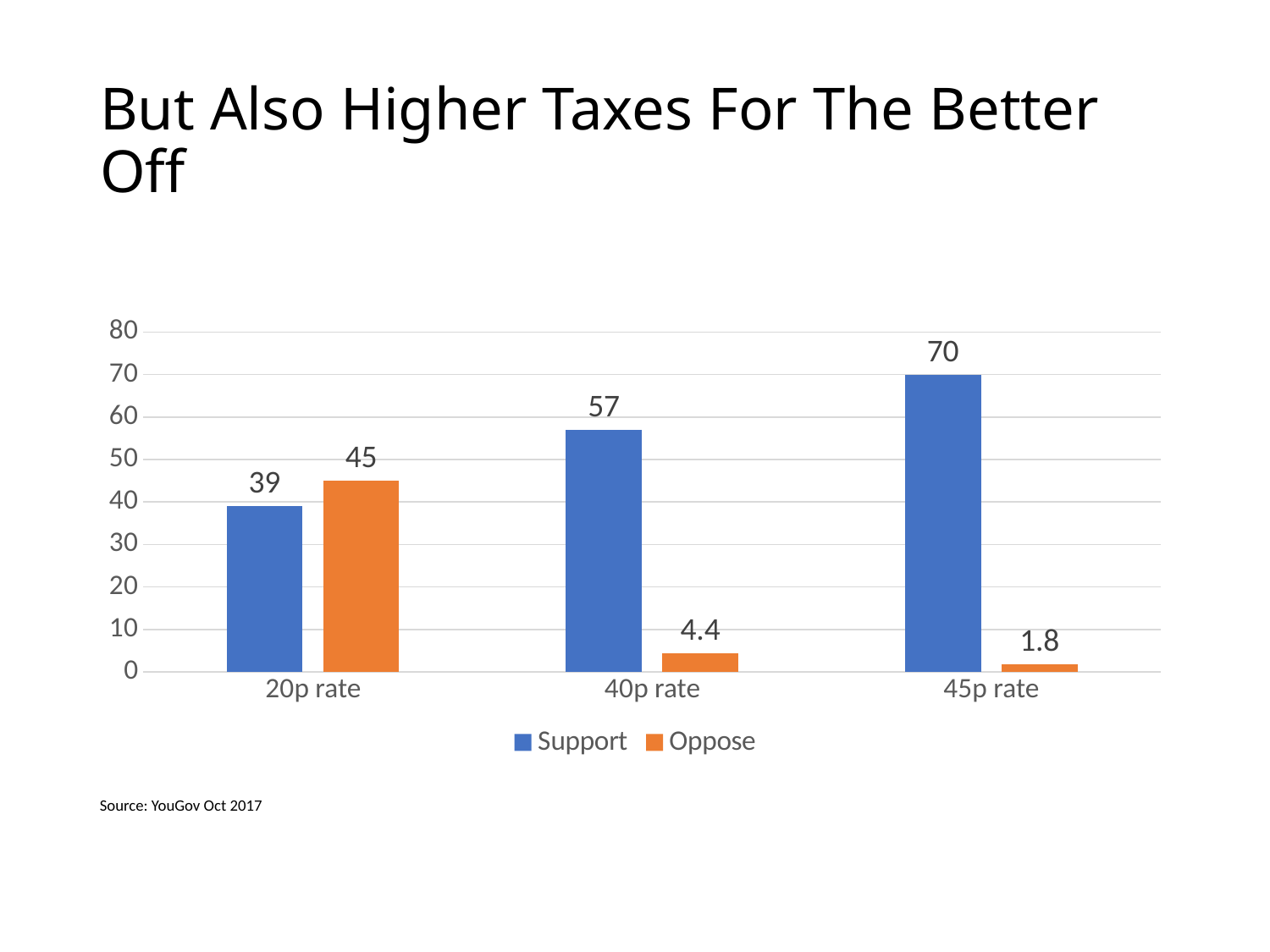
What is the Oppose value for the 20p rate? 45 Which category has the lowest Oppose value? 45p rate What is the Support value for the 45p rate? 70 Do the Support values rise or fall from the 20p rate to the 45p rate? Rise How many series does the legend list? 2 How many categories are shown on the x axis? 3 What is the difference between the Support values for the 45p rate and the 20p rate? 31 What kind of chart is shown on the slide? Bar chart What is the Oppose value for the 40p rate? 4.4 What colour are the Oppose bars? Orange Which category has the highest Support value? 45p rate For the 20p rate, which is larger: Support or Oppose? Oppose